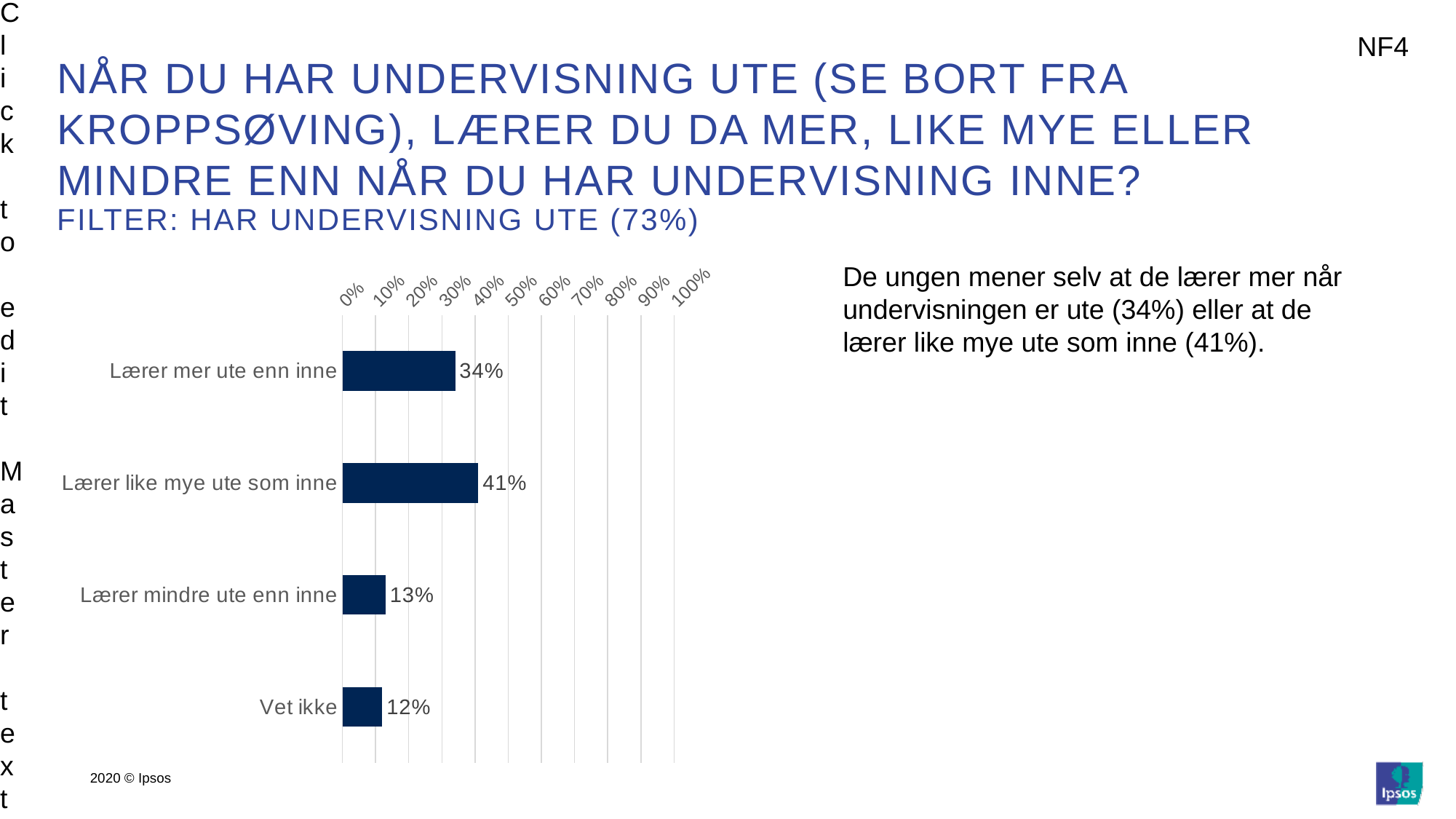
How many categories are shown in the chart? 4 Which category has the lowest value? Vet ikke What kind of chart is shown on the slide? bar chart What is the value for "Lærer mindre ute enn inne"? 13% Which is larger, "Lærer mer ute enn inne" or "Lærer mindre ute enn inne"? Lærer mer ute enn inne What is the value for "Vet ikke"? 12% Which category has the highest value? Lærer like mye ute som inne What is the value for "Lærer like mye ute som inne"? 41% What is the difference between "Lærer like mye ute som inne" and "Lærer mer ute enn inne"? 7% Is the value for "Lærer like mye ute som inne" greater or less than 50%? less What is the highest value shown on the percentage axis? 100% What is the value for "Lærer mer ute enn inne"? 34%